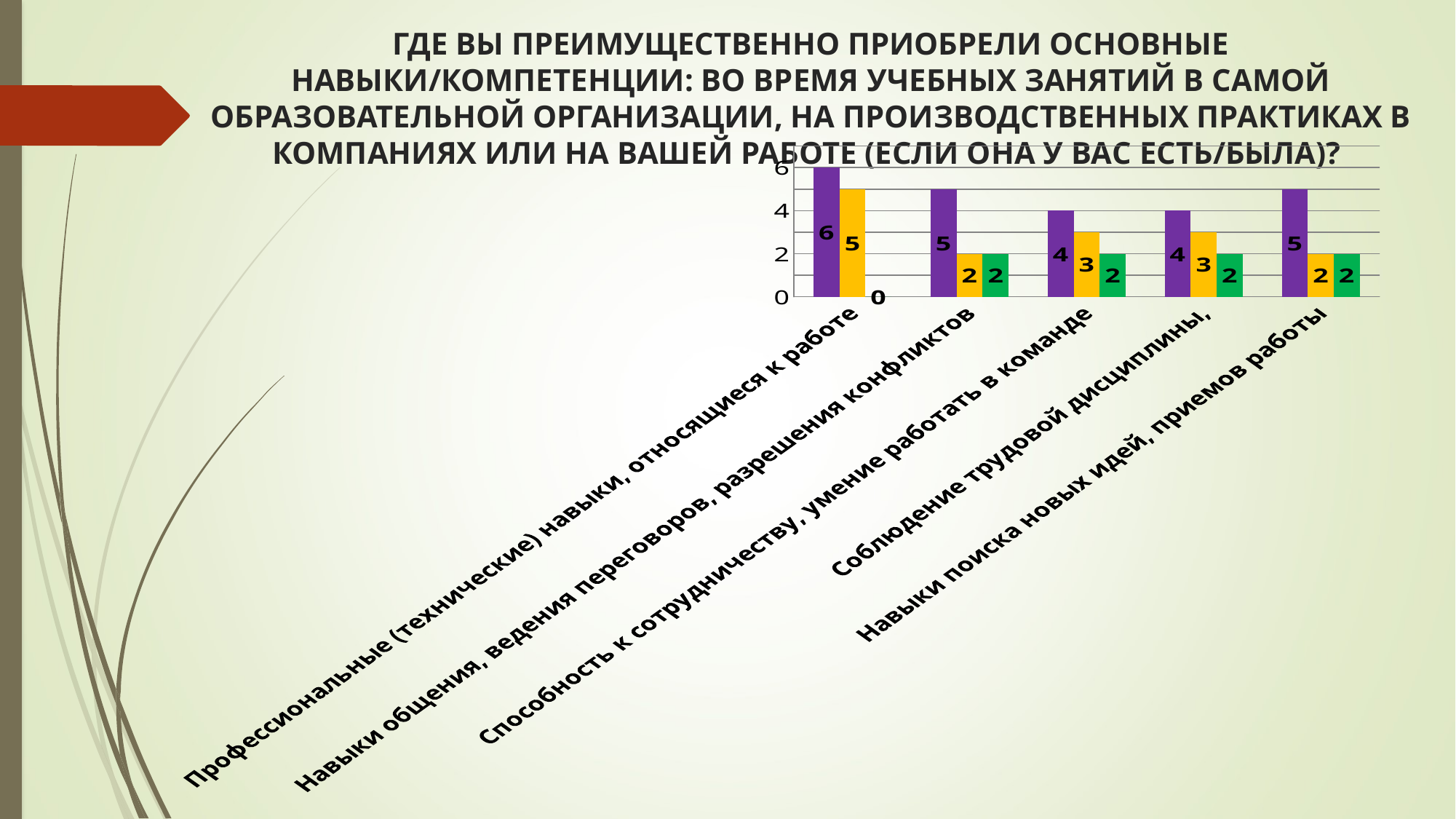
What is the value of the purple bar for "Профессиональные (технические) навыки, относящиеся к работе"? 6 What is the value of the purple bar for "Навыки поиска новых идей, приемов работы"? 5 What is the value of the green bar for "Профессиональные (технические) навыки, относящиеся к работе"? 0 How many bars are shown for each category in the chart? 3 What is the difference between the purple bar and the yellow bar for "Навыки общения, ведения переговоров, разрешения конфликтов"? 3 Which is larger for "Соблюдение трудовой дисциплины": the purple bar or the green bar? the purple bar Which category has the highest purple bar? Профессиональные (технические) навыки, относящиеся к работе What is the total of the three bars for "Способность к сотрудничеству, умение работать в команде"? 9 What is the value of the yellow bar for "Способность к сотрудничеству, умение работать в команде"? 3 What is the value of the yellow bar for "Профессиональные (технические) навыки, относящиеся к работе"? 5 What kind of chart is shown on the slide? bar chart How many categories are shown on the x axis of the chart? 5